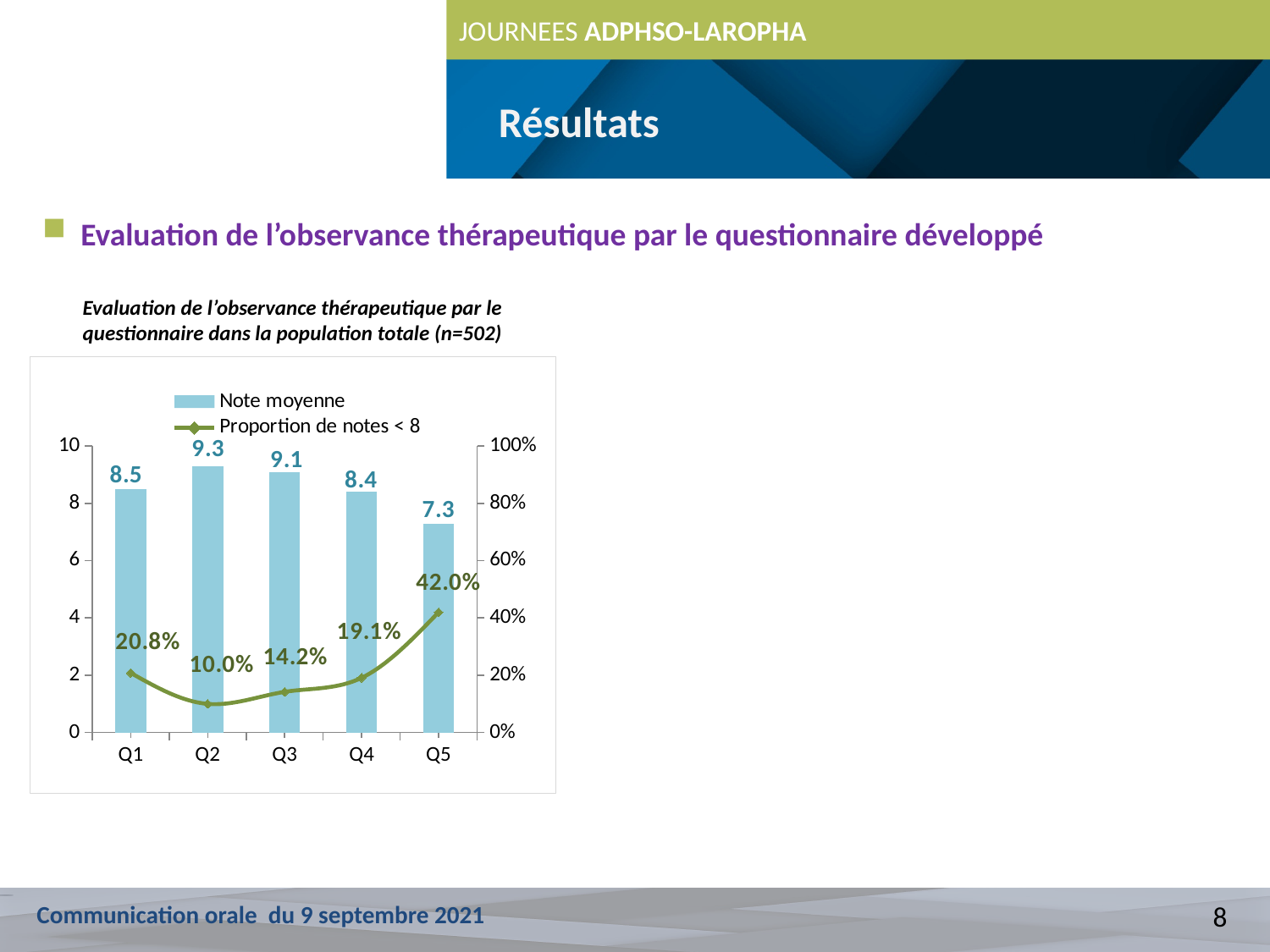
What is the difference between the Note moyenne for Q2 and Q5? 2.0 How many questions (categories) are shown on the x axis? 5 Which has a higher Proportion de notes < 8, Q1 or Q4? Q1 What is the Proportion de notes < 8 for Q5? 42.0% What is the Note moyenne for Q2? 9.3 What is the sample size (n) stated in the chart title? n=502 Which question has the highest Note moyenne? Q2 Which question has the lowest Proportion de notes < 8? Q2 What is the Note moyenne for Q5? 7.3 What kind of chart is used for the Note moyenne series? Bar chart Does the Proportion de notes < 8 rise or fall from Q2 to Q5? Rise How many series does the legend list? 2